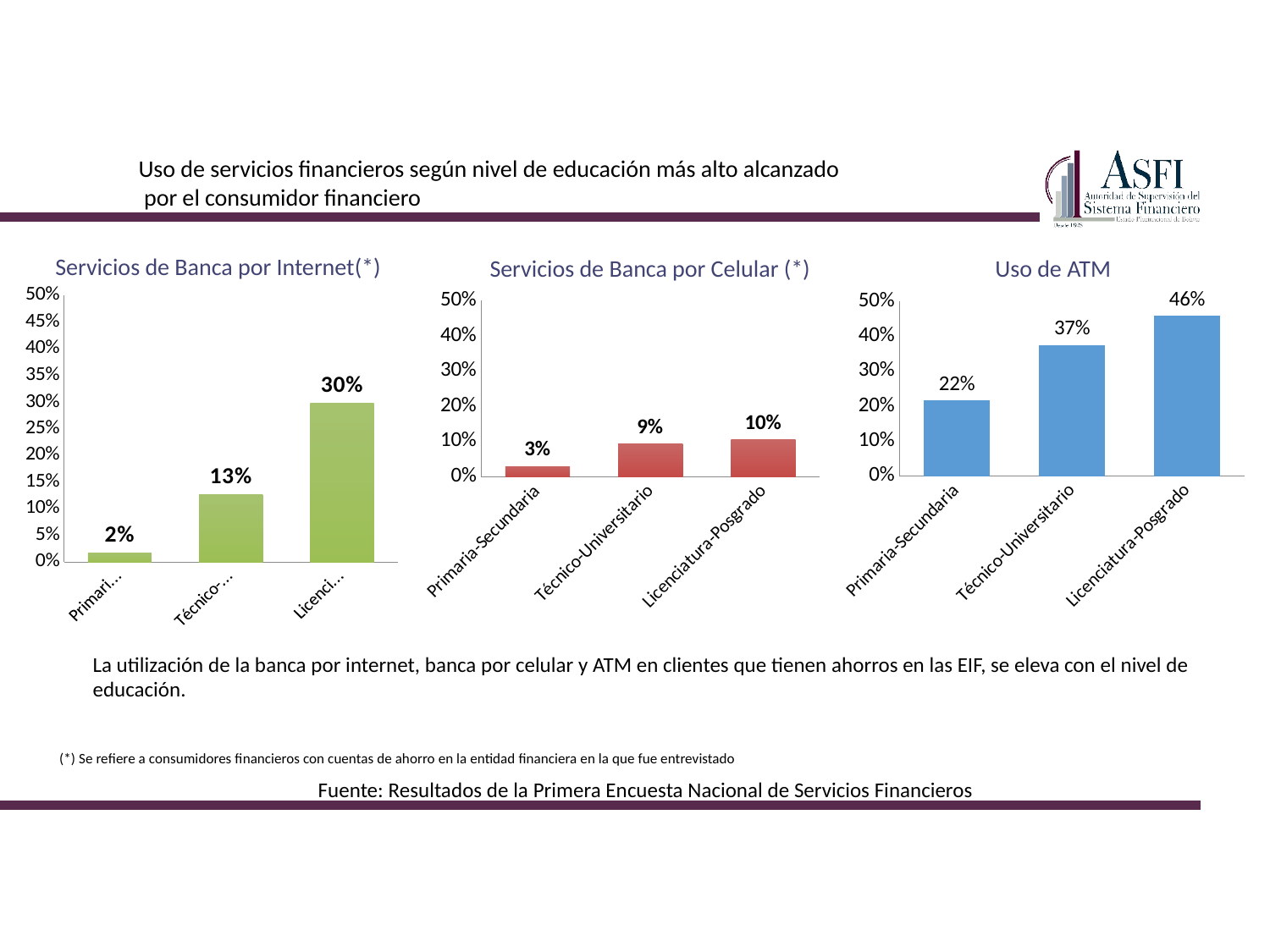
In the 'Uso de ATM' chart, do the values rise or fall from left to right? Rise In the 'Servicios de Banca por Celular (*)' chart, which category has the lowest value? Primaria-Secundaria What type of chart is 'Servicios de Banca por Celular (*)'? Bar chart In the 'Servicios de Banca por Internet(*)' chart, what is the value of the tallest bar? 30% In the 'Uso de ATM' chart, which category has the highest value? Licenciatura-Posgrado In the 'Uso de ATM' chart, what is the value for Técnico-Universitario? 37% In the 'Servicios de Banca por Celular (*)' chart, what is the value for Primaria-Secundaria? 3% In the 'Servicios de Banca por Internet(*)' chart, what is the difference between the tallest and the shortest bar? 28% In the 'Uso de ATM' chart, is the value for Primaria-Secundaria greater or less than 30%? less In the 'Servicios de Banca por Celular (*)' chart, which is larger: Técnico-Universitario or Licenciatura-Posgrado? Licenciatura-Posgrado In the 'Uso de ATM' chart, what is the difference between Licenciatura-Posgrado and Primaria-Secundaria? 24% How many bars does the 'Uso de ATM' chart have? 3